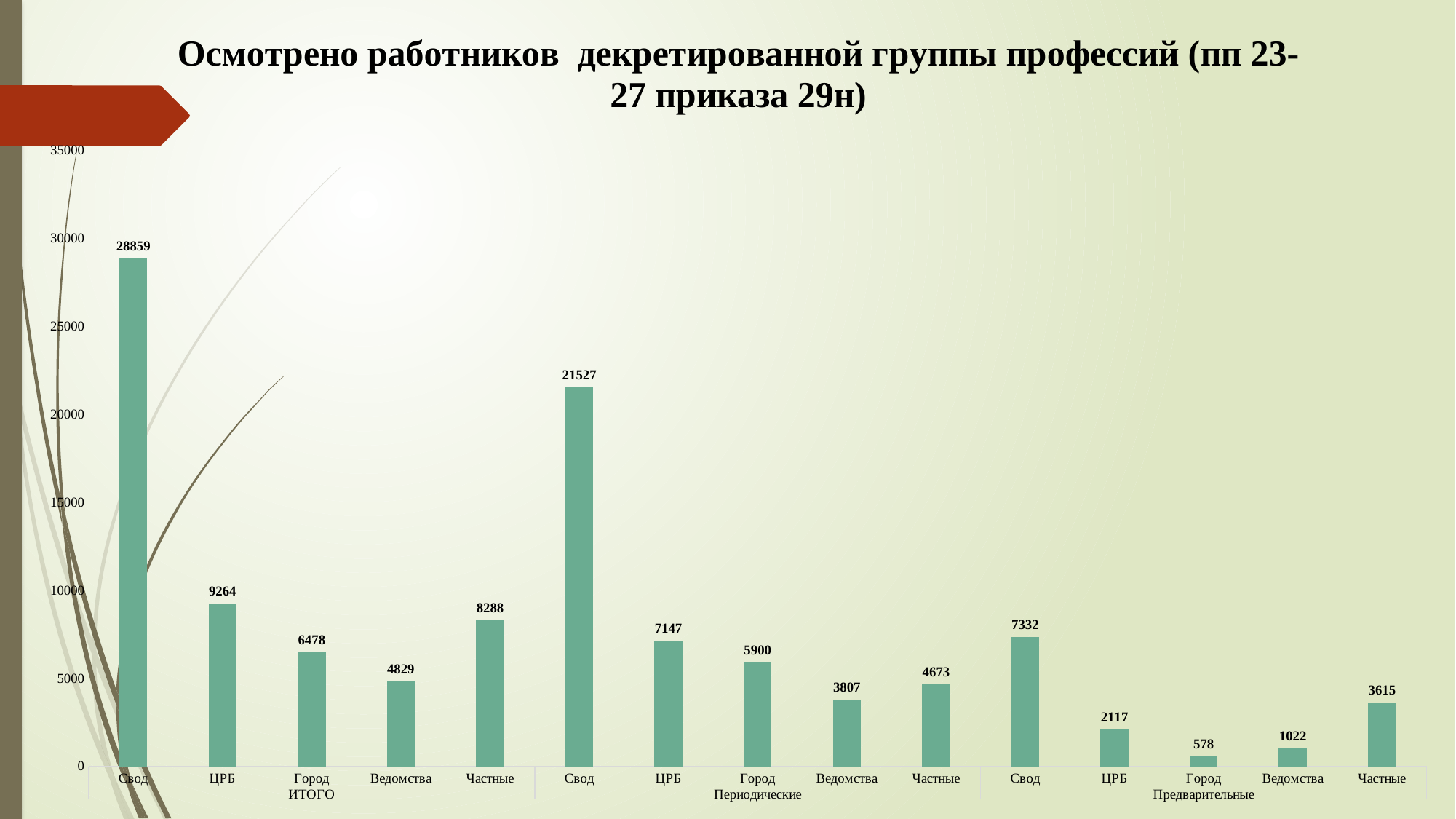
What is the value for Частные in the Периодические group? 4673 What is the difference between ЦРБ and Город in the Предварительные group? 1539 Which is larger: ЦРБ in the Периодические group or Частные in the ИТОГО group? Частные in the ИТОГО group What is the value for Ведомства in the ИТОГО group? 4829 How many bars are plotted on the chart? 15 What is the difference between Свод in the Периодические group and Свод in the Предварительные group? 14195 Which bar has the lowest value on the chart? Город (Предварительные) What is the value for Свод in the ИТОГО group? 28859 How many groups are labelled along the x axis? 3 What is the value for Город in the Предварительные group? 578 Which bar has the highest value on the chart? Свод (ИТОГО) What kind of chart is shown on the slide? Bar chart